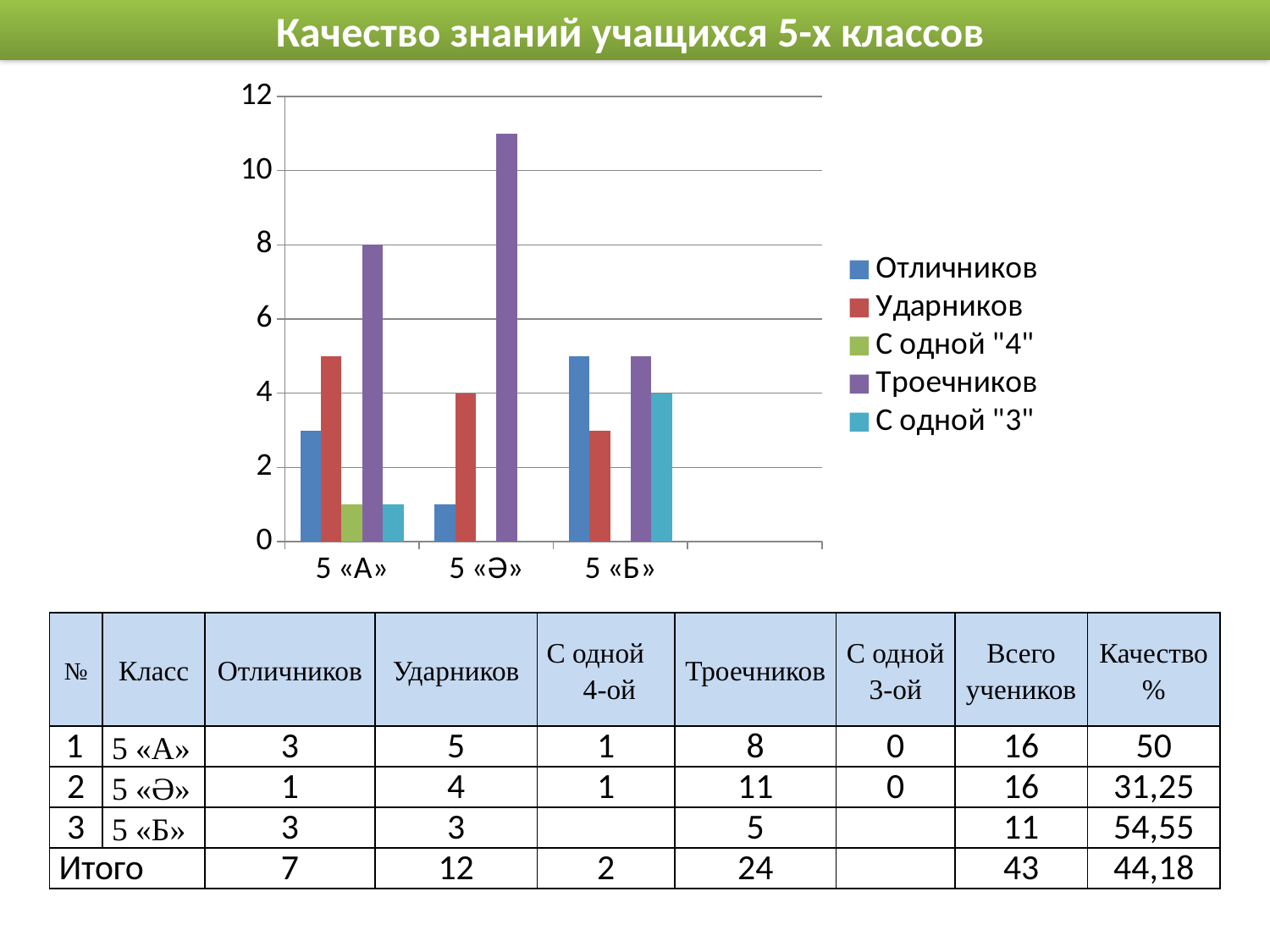
How many classes (categories) are shown on the x axis of the chart? 3 What is the value of Троечников for class 5 «А» in the chart? 8 Do the Ударников values rise or fall from 5 «А» to 5 «Б» along the x axis? fall Is the Отличников value for class 5 «А» greater or less than 2? greater What is the value of С одной "3" for class 5 «Б» in the chart? 4 What is the value of Ударников for class 5 «Ә» in the chart? 4 What type of chart is shown on the slide? bar chart How many series does the chart legend list? 5 Is the Троечников value for class 5 «Ә» greater or less than 10? greater Which class has the lowest Троечников bar in the chart? 5 «Б» Which is larger in the chart: Троечников for 5 «А» or Троечников for 5 «Б»? 5 «А» Which class has the highest Троечников bar in the chart? 5 «Ә»